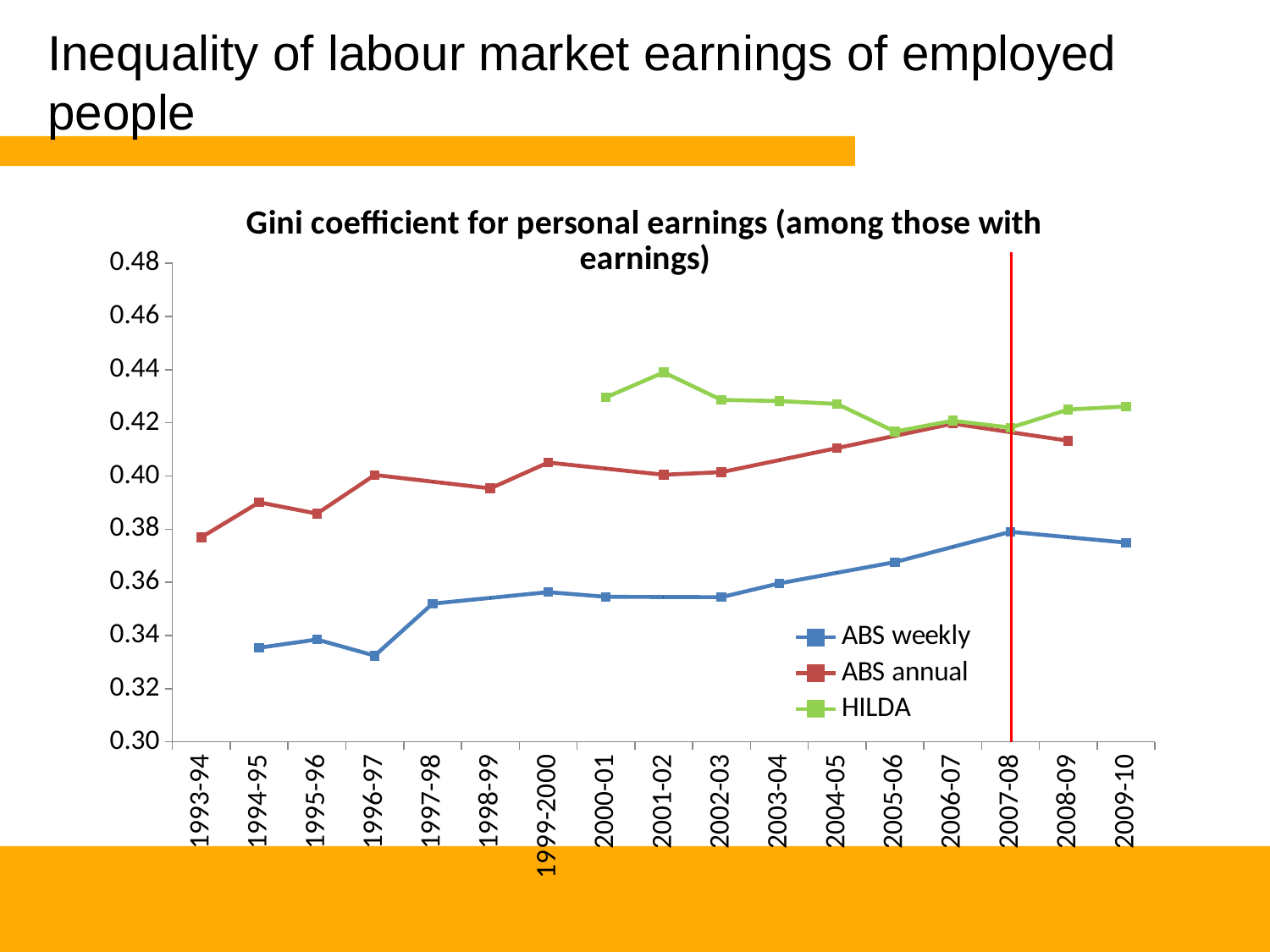
Is the ABS annual value for 1993-94 greater or less than 0.38? less How many year categories are shown on the x axis? 17 Does the ABS annual series generally rise or fall from 1993-94 to 2006-07? rise In which year is the HILDA series at its highest? 2001-02 How many series does the legend list? 3 In 2001-02, which is larger: the HILDA value or the ABS annual value? HILDA Is the ABS weekly value for 1996-97 greater or less than 0.34? less What kind of chart is shown on the slide? line chart Is the HILDA value for 2001-02 greater or less than 0.42? greater In which year is the ABS annual series at its lowest? 1993-94 Which series is drawn in green? HILDA What is the title of the chart? Gini coefficient for personal earnings (among those with earnings)